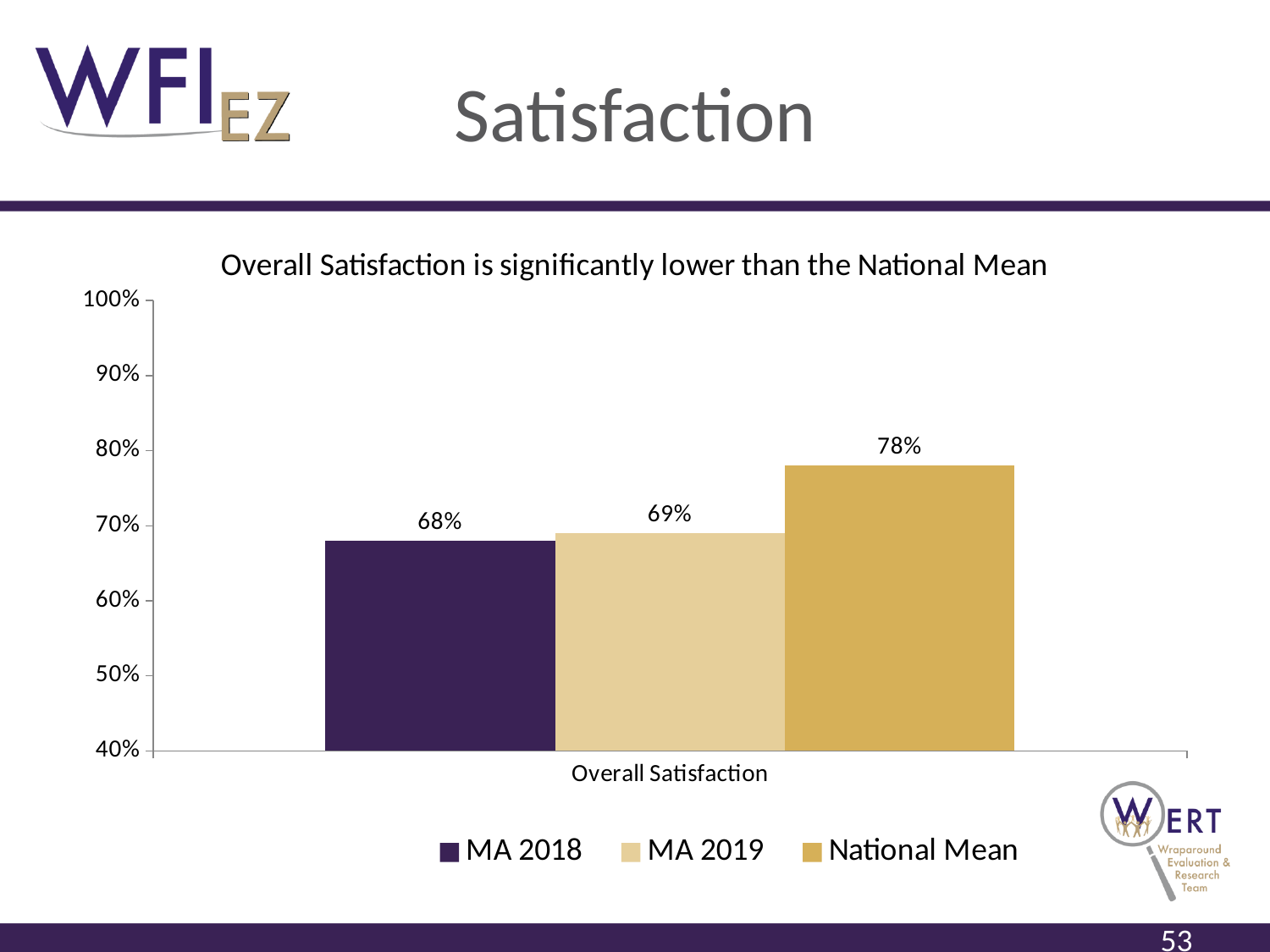
What kind of chart is shown on the slide? Bar chart What is the difference between the National Mean and MA 2019 for Overall Satisfaction? 9% What is the value for the National Mean for Overall Satisfaction? 78% How many series does the legend list? 3 Which series has the highest value for Overall Satisfaction? National Mean What is the difference between MA 2019 and MA 2018 for Overall Satisfaction? 1% What is the value for MA 2019 for Overall Satisfaction? 69% What is the value for MA 2018 for Overall Satisfaction? 68% Which series has the lowest value for Overall Satisfaction? MA 2018 Is the value for the National Mean greater or less than 70%? greater What is the title of the chart? Overall Satisfaction is significantly lower than the National Mean Which is larger, the MA 2018 value or the National Mean value? National Mean